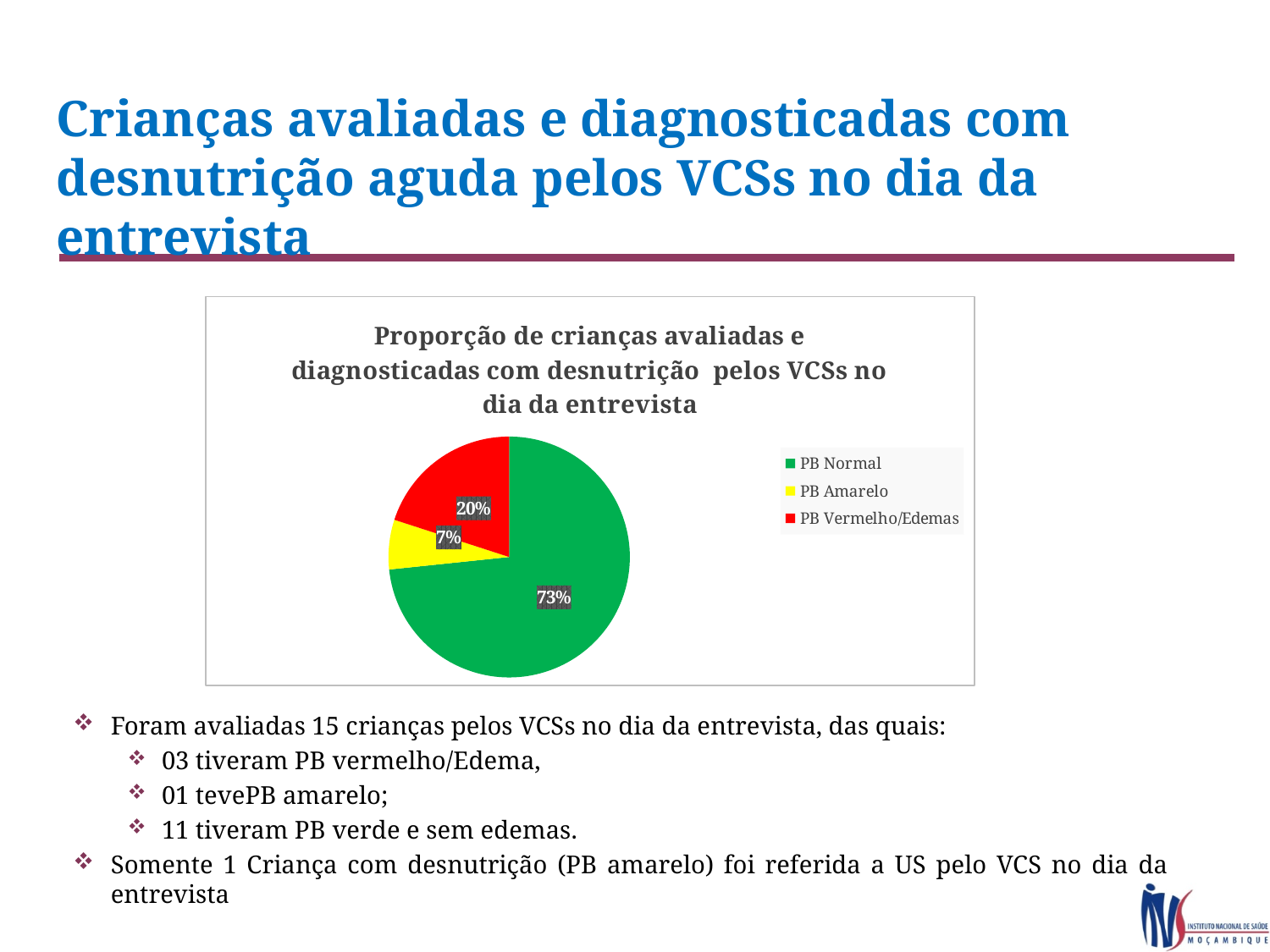
Which category has the largest slice of the pie? PB Normal What share of the pie does PB Vermelho/Edemas represent? 20% What share of the pie does PB Normal represent? 73% What is the difference in percentage points between PB Normal and PB Vermelho/Edemas? 53 What colour is the PB Amarelo slice? yellow Which category has the smallest slice of the pie? PB Amarelo What share of the pie does PB Amarelo represent? 7% Which is larger, the slice for PB Amarelo or the slice for PB Vermelho/Edemas? PB Vermelho/Edemas What kind of chart is shown on the slide? pie chart How many categories does the pie chart show? 3 What colour is the PB Vermelho/Edemas slice? red What is the difference in percentage points between PB Vermelho/Edemas and PB Amarelo? 13